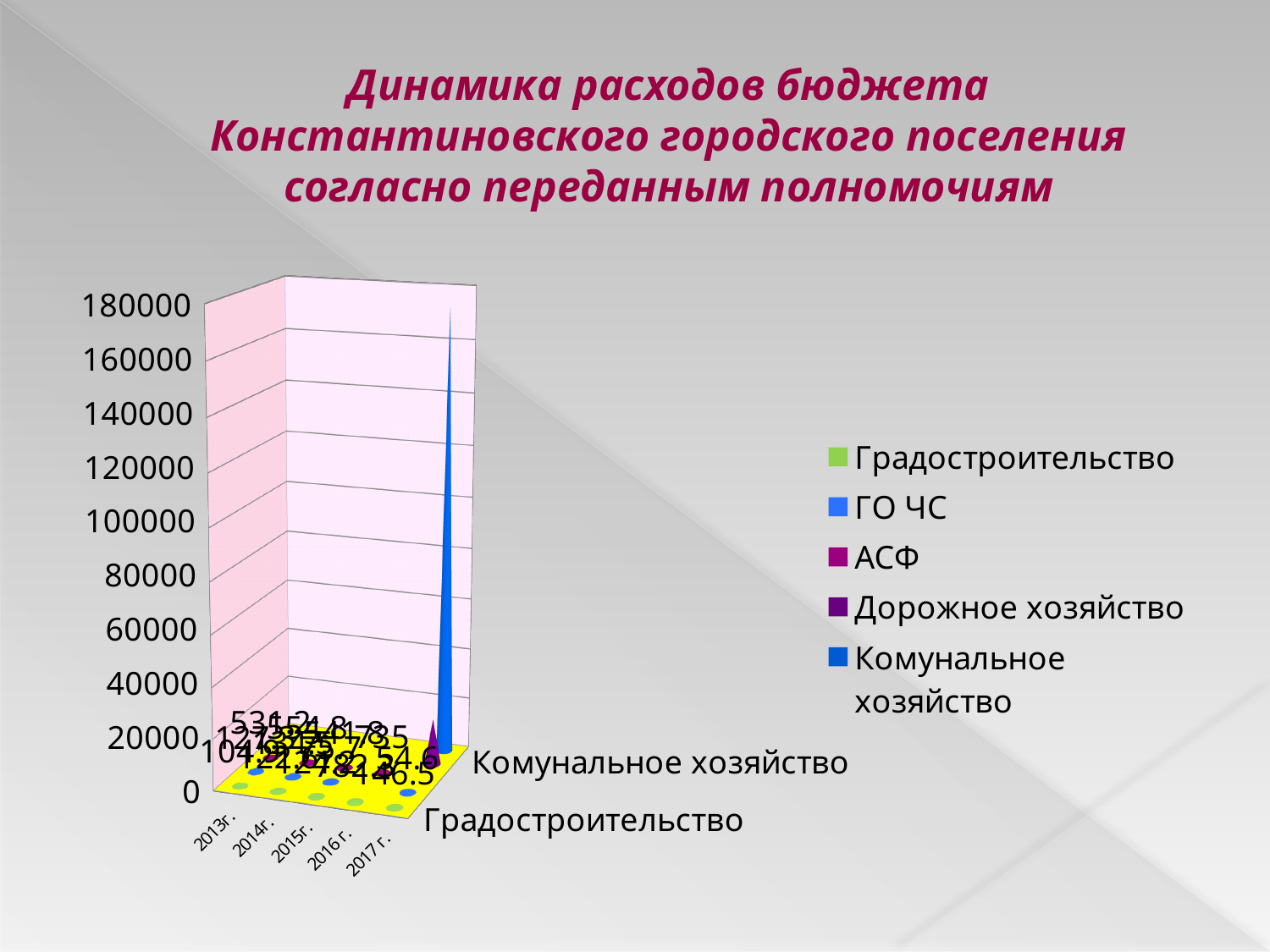
Which series has the tallest bar on the chart? Комунальное хозяйство What is the highest value shown on the vertical axis? 180000 Which is larger: Комунальное хозяйство in 2017 г. or Дорожное хозяйство in 2017 г.? Комунальное хозяйство in 2017 г. What kind of chart is shown on the slide? bar chart How many series does the legend list? 5 Is the value for Комунальное хозяйство in 2017 г. greater or less than 100000? greater Is the value for Комунальное хозяйство in 2017 г. greater or less than 140000? greater In which year does the Комунальное хозяйство series reach its highest value? 2017 г. What is the first year shown on the x axis? 2013г. How many years are shown along the x axis? 5